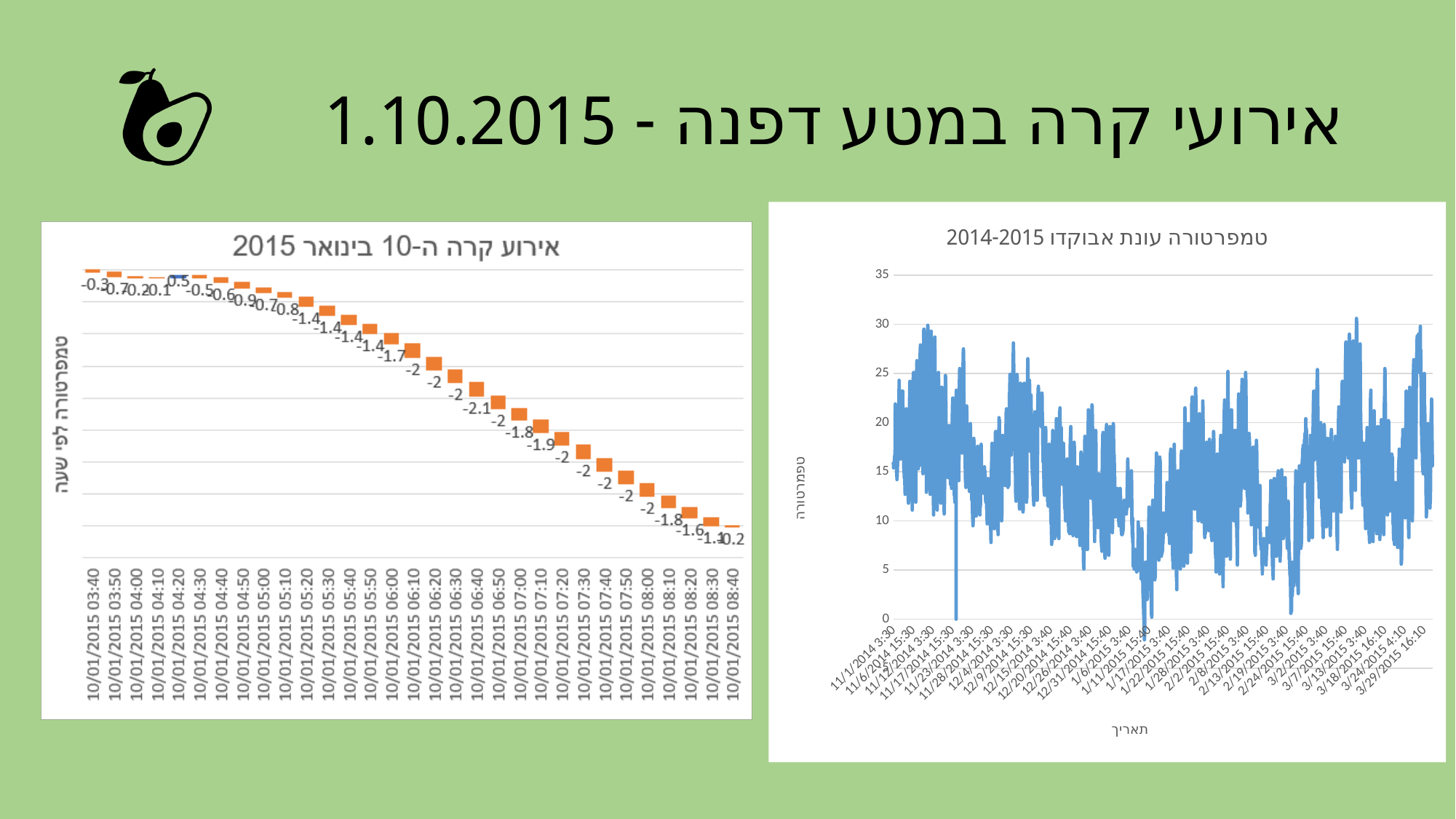
In the right chart (טמפרטורה עונת אבוקדו 2014-2015), what is the x-axis title? תאריך In the left chart (אירוע קרה ה-10 בינואר 2015), at which time is the temperature lowest? 10/01/2015 06:40 In the left chart (אירוע קרה ה-10 בינואר 2015), which is higher: the temperature at 05:20 or at 07:00? 05:20 In the left chart (אירוע קרה ה-10 בינואר 2015), how many time points are plotted on the x axis? 31 In the right chart (טמפרטורה עונת אבוקדו 2014-2015), is the highest temperature reached greater or less than 25? greater In the left chart (אירוע קרה ה-10 בינואר 2015), what is the temperature at 10/01/2015 06:40? -2.1 In the left chart (אירוע קרה ה-10 בינואר 2015), what is the temperature at 10/01/2015 08:20? -1.6 In the left chart (אירוע קרה ה-10 בינואר 2015), at which time is the temperature highest? 10/01/2015 04:20 In the left chart (אירוע קרה ה-10 בינואר 2015), what is the difference between the temperature at 06:00 and at 06:40? 0.4 In the left chart (אירוע קרה ה-10 בינואר 2015), what is the temperature at 10/01/2015 08:40? -0.2 What kind of chart is the right chart (טמפרטורה עונת אבוקדו 2014-2015)? line chart In the left chart (אירוע קרה ה-10 בינואר 2015), what is the temperature at 10/01/2015 04:20? 0.5